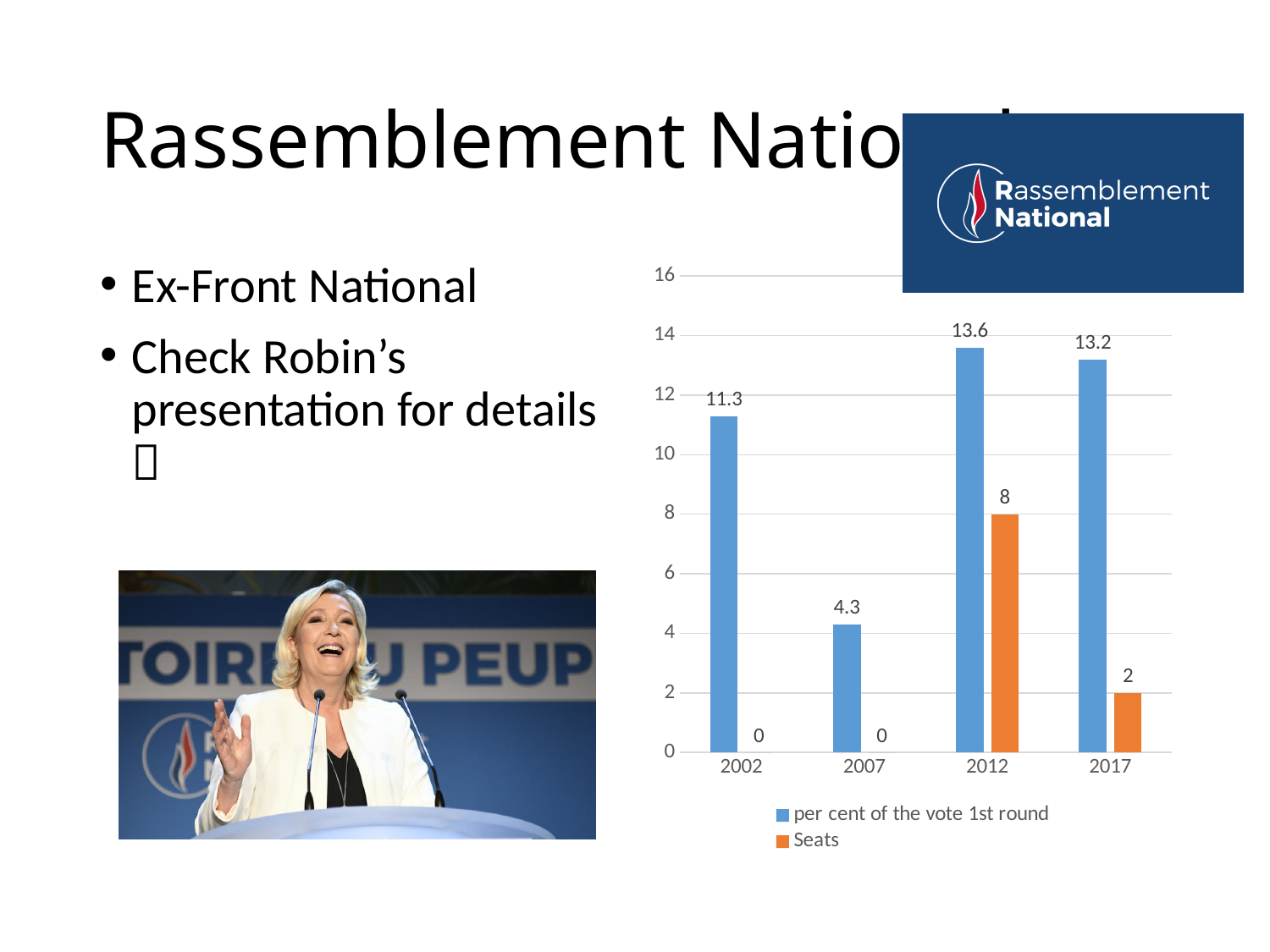
How many series does the chart legend list? 2 Is the per cent of the vote in the 1st round in 2002 greater or less than 10? greater Which colour represents the Seats series in the chart? orange How many seats were won in 2017? 2 What is the difference between the per cent of the vote in the 1st round in 2012 and in 2017? 0.4 In which year was the per cent of the vote in the 1st round highest? 2012 In which year was the per cent of the vote in the 1st round lowest? 2007 How many years are shown on the x axis of the chart? 4 What was the per cent of the vote in the 1st round in 2012? 13.6 What was the per cent of the vote in the 1st round in 2007? 4.3 What kind of chart is shown on the slide? bar chart Which year had more seats, 2012 or 2017? 2012